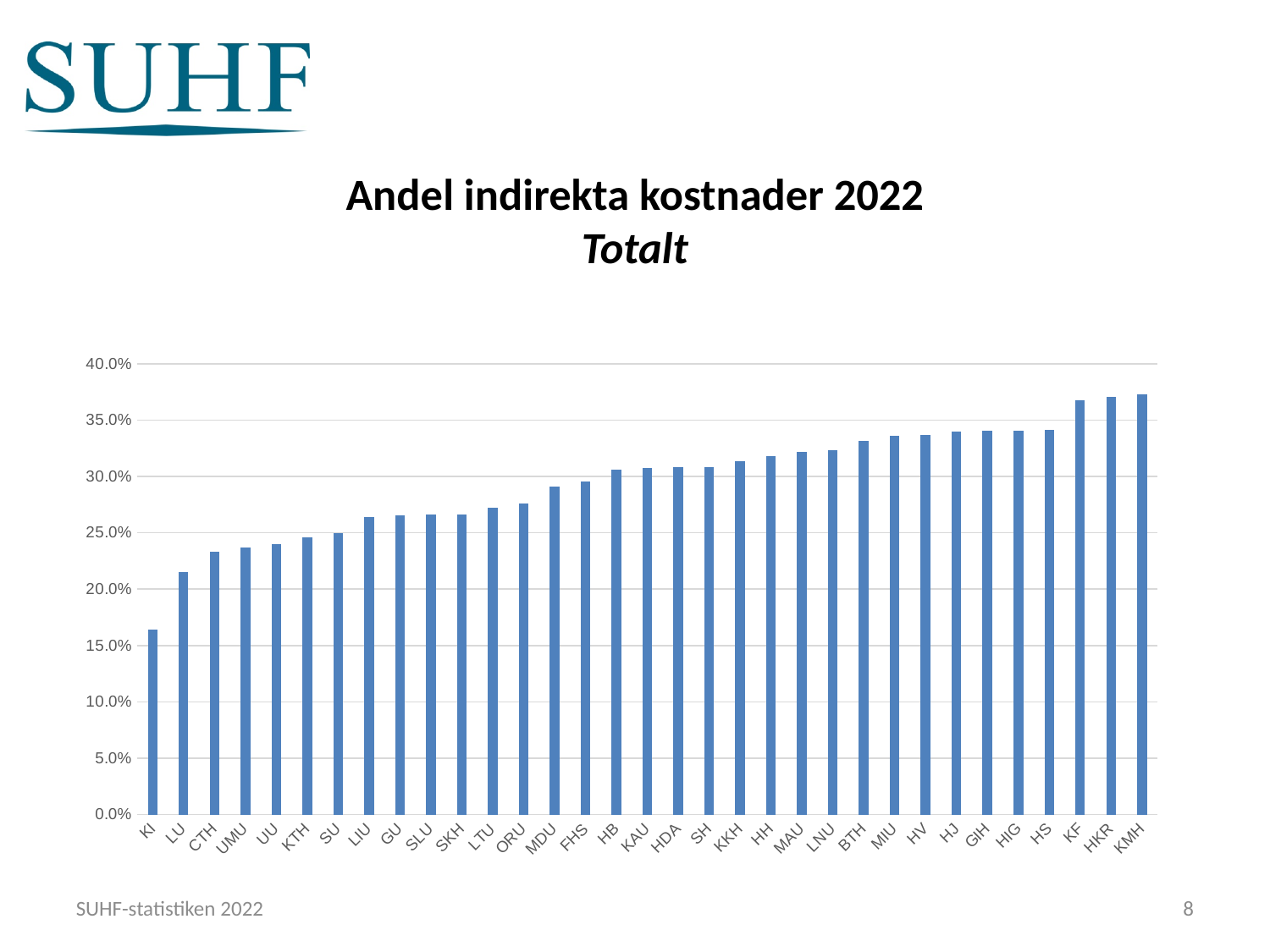
Which has a larger value, CTH or BTH? BTH Is the value for KKH greater or less than 30.0%? greater Which institution has the highest share of indirect costs? KMH Is the value for UU greater or less than 25.0%? less Do the values rise or fall from left to right along the x axis? rise Is the value for LU greater or less than 20.0%? greater How many institutions (bars) are shown in the chart? 33 Which institution has the lowest share of indirect costs? KI What is the title of the chart? Andel indirekta kostnader 2022 Totalt What kind of chart is shown on the slide? bar chart